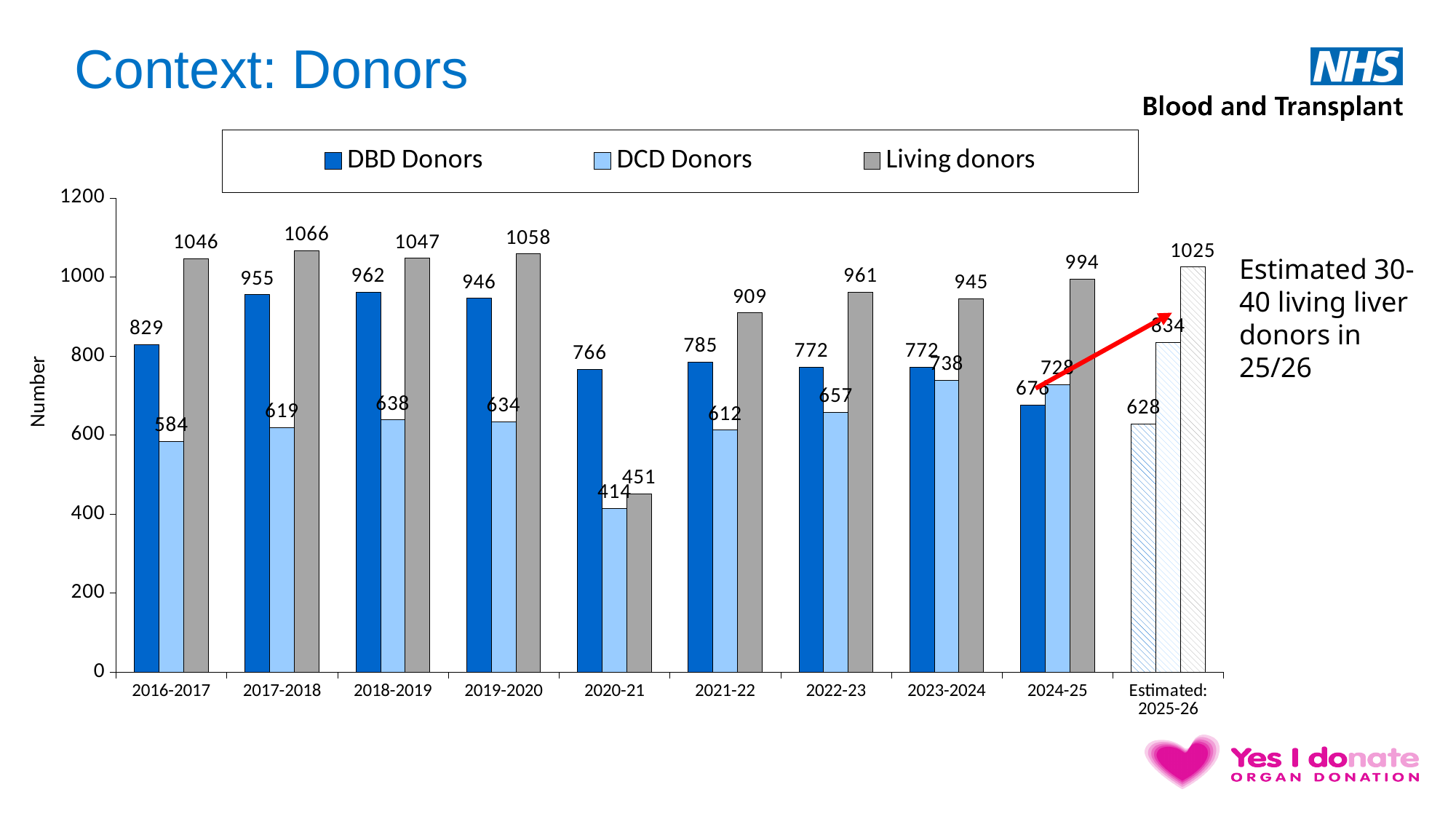
What is the number of DCD Donors in 2020-21? 414 In which year is the number of Living donors lowest? 2020-21 What is the number of Living donors in 2017-2018? 1066 How many year categories are shown on the x axis? 10 What kind of chart is shown on the slide? bar chart Is the number of Living donors in 2021-22 greater or less than 800? greater Which is larger in 2022-23, DBD Donors or DCD Donors? DBD Donors What is the difference between Living donors and DBD Donors in 2016-2017? 217 What is the number of DBD Donors in 2018-2019? 962 In which year is the number of DBD Donors highest? 2018-2019 How many series does the legend list? 3 What is the estimated number of Living donors for 2025-26? 1025